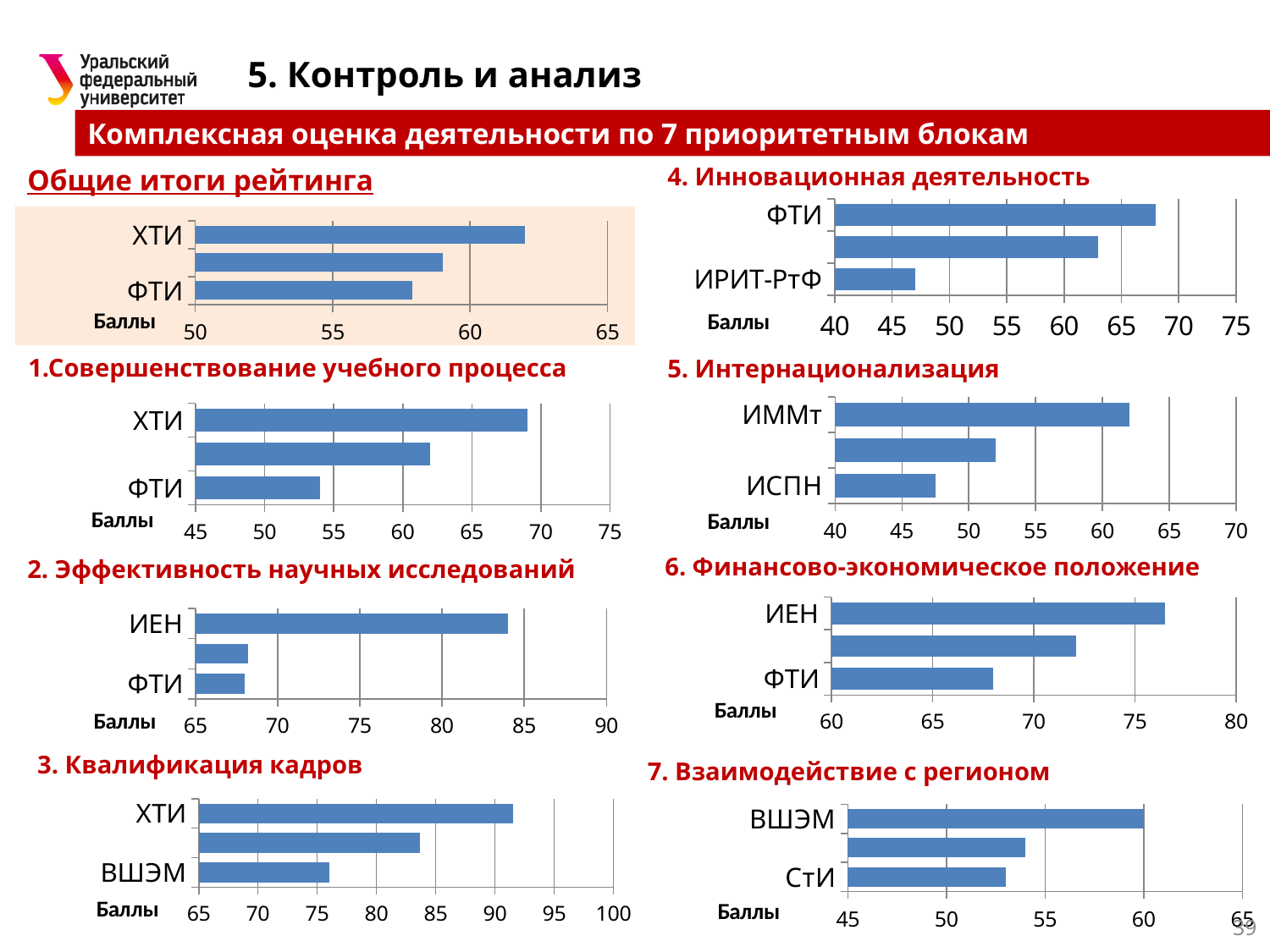
In the chart titled "6. Финансово-экономическое положение", is the value for ИЕН greater or less than 75? greater In the chart titled "Общие итоги рейтинга", which category has the highest value? ХТИ In the chart titled "1.Совершенствование учебного процесса", which category has the lowest value? ФТИ In the chart titled "Общие итоги рейтинга", is the value for ХТИ greater or less than 60? greater In the chart titled "2. Эффективность научных исследований", is the value for ИЕН greater or less than 80? greater How many bars does the chart titled "3. Квалификация кадров" show? 3 In the chart titled "5. Интернационализация", which category has the highest value? ИММт What kind of chart is used for "6. Финансово-экономическое положение"? Bar chart In the chart titled "3. Квалификация кадров", which is larger, the value for ХТИ or the value for ВШЭМ? ХТИ In the chart titled "7. Взаимодействие с регионом", which category has the highest value? ВШЭМ